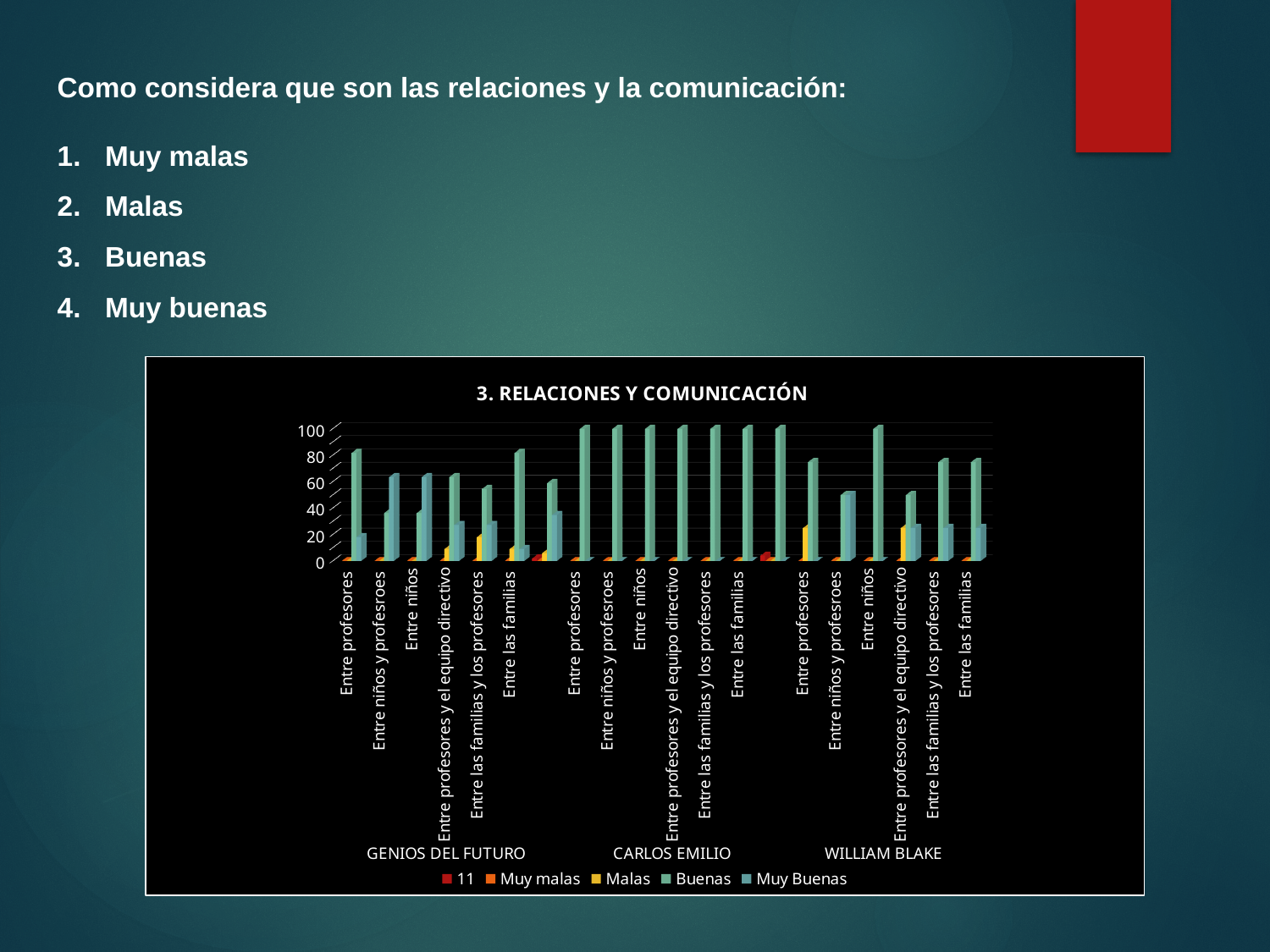
In the CARLOS EMILIO group, which series has the tallest bars across the categories? Buenas How many series does the chart legend list? 5 What kind of chart is shown on the slide? bar chart How many school groups are shown along the x axis of the chart? 3 What is the title of the chart? 3. RELACIONES Y COMUNICACIÓN Is the Buenas value for Entre profesores in the WILLIAM BLAKE group greater or less than 60? greater Is the Buenas value for Entre profesores in the GENIOS DEL FUTURO group greater or less than 60? greater Which series is shown in red in the chart legend? 11 Is the Buenas value for Entre las familias in the CARLOS EMILIO group greater or less than 80? greater In the GENIOS DEL FUTURO group, which is larger for Entre profesores: Buenas or Muy Buenas? Buenas